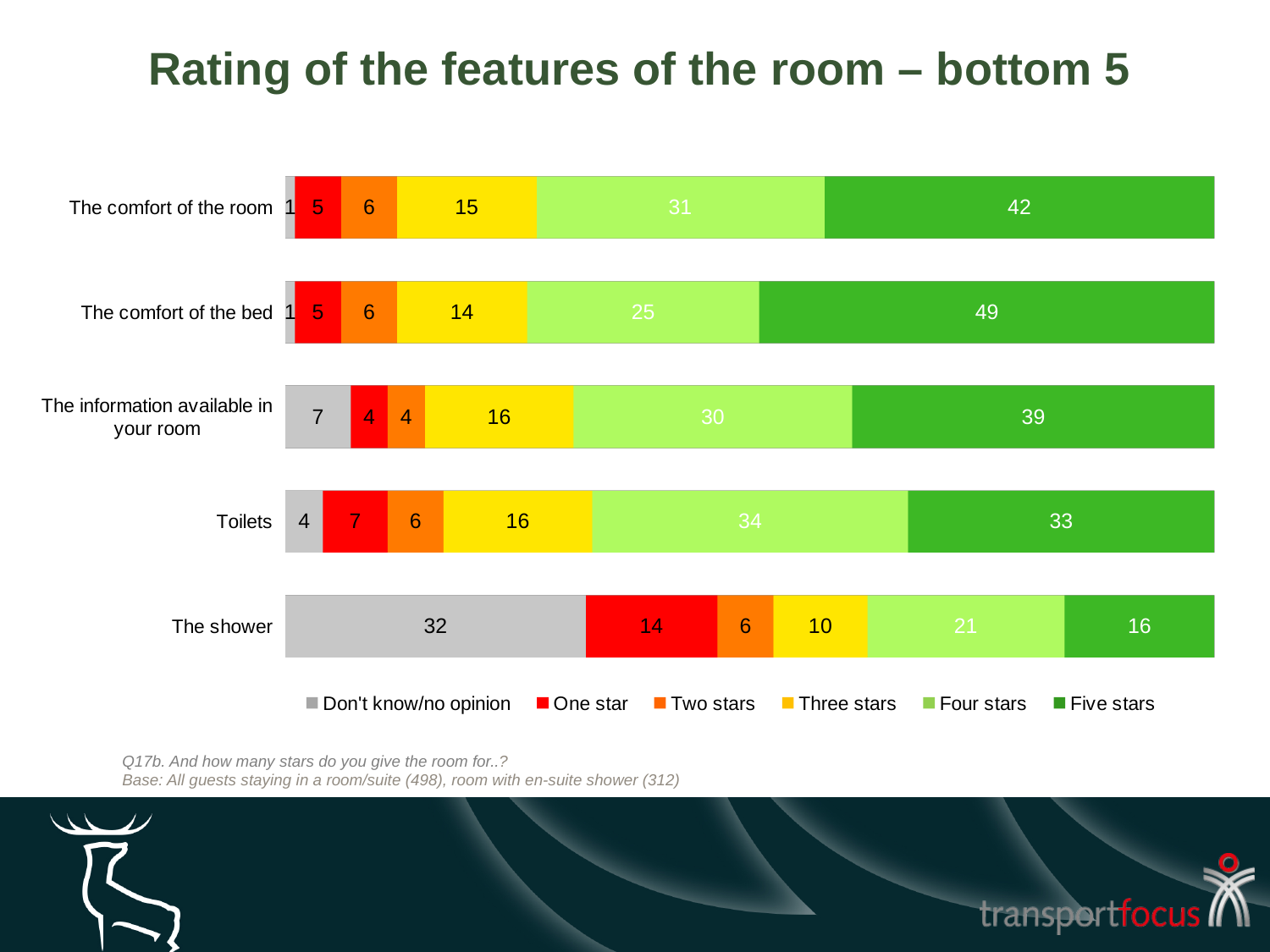
Which category has the lowest Five stars value? The shower What kind of chart is shown on the slide? Stacked bar chart What is the total of the stacked bar for The shower? 99 Which category has the highest Five stars value? The comfort of the bed How many categories are shown on the chart? 5 What is the Four stars value for Toilets? 34 How many series does the legend list? 6 What is the Five stars value for The comfort of the bed? 49 Which is larger: the Four stars value for The comfort of the room or for The comfort of the bed? The comfort of the room What is the difference between the Five stars values for The comfort of the room and The shower? 26 What is the Three stars value for The information available in your room? 16 What is the Don't know/no opinion value for The shower? 32